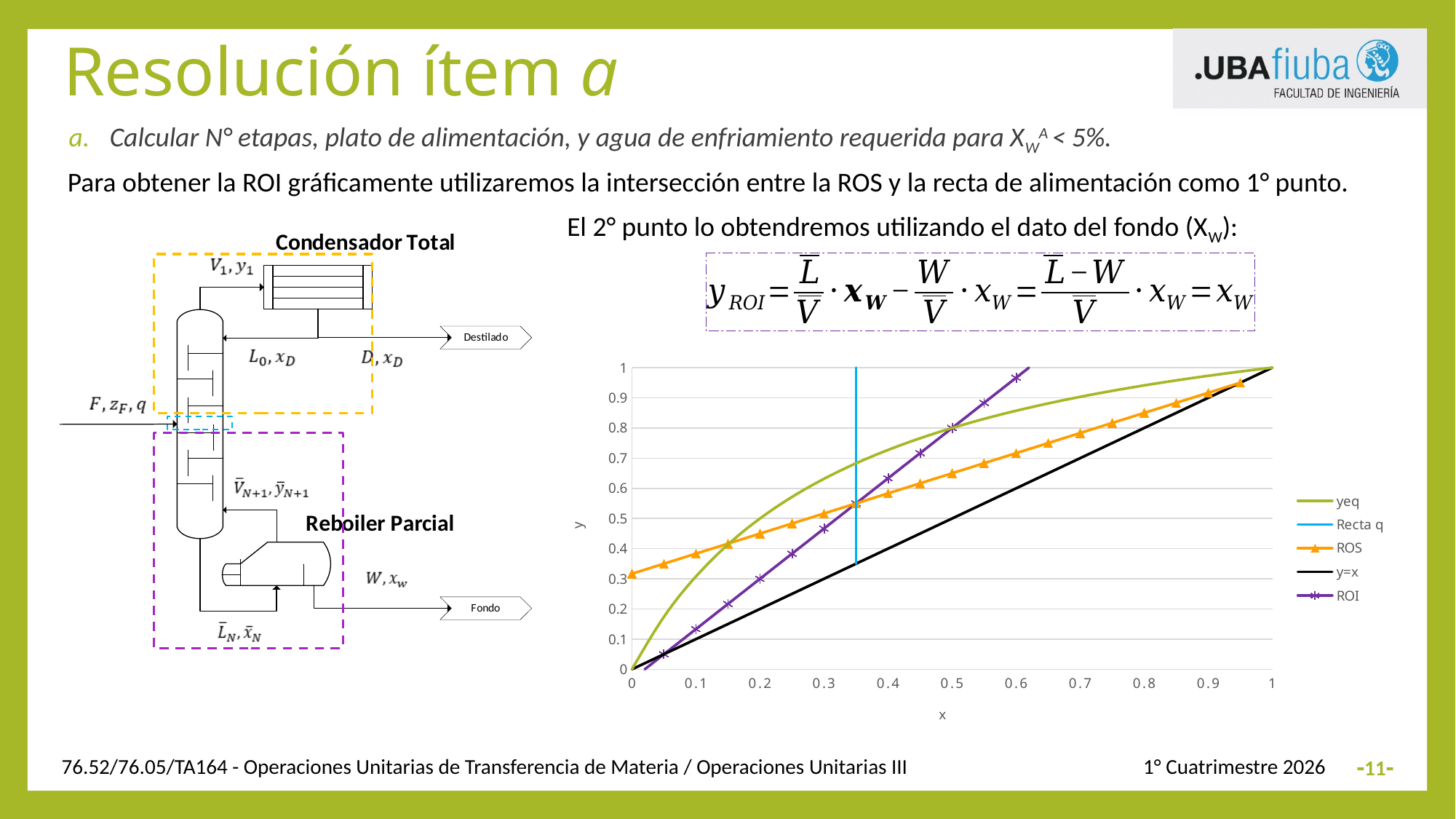
Is the value of the yeq curve at x = 0.3 greater or less than 0.6? greater At x = 0.1, which series has the higher y value, ROS or y=x? ROS Is the value of the ROI line at x = 0.2 greater or less than 0.4? less How many series does the chart legend list? 5 Which series in the legend is drawn as a vertical line? Recta q Is the value of the ROI line at x = 0.6 greater or less than 0.9? greater What is the label of the horizontal axis of the chart? x Does the yeq curve rise or fall as x increases from 0 to 1? rise What kind of chart is shown on the slide? line chart At x = 0.2, which series has the higher y value, yeq or ROS? yeq